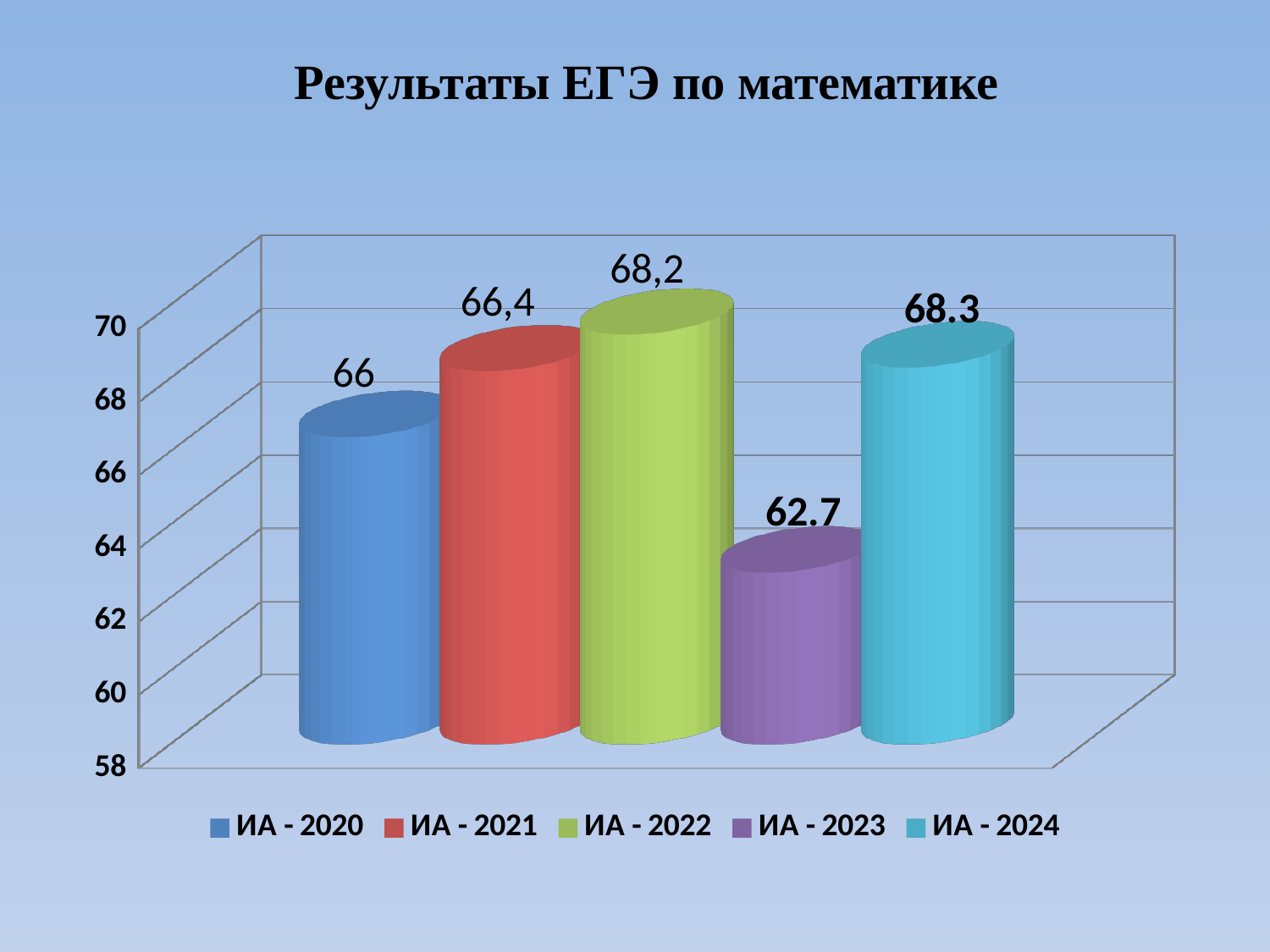
What is the value for ИА - 2023? 62.7 What kind of chart is shown on the slide? bar chart How many series does the legend list? 5 What is the difference between the values for ИА - 2024 and ИА - 2023? 5.6 Which series has the lowest value? ИА - 2023 What is the value for ИА - 2024? 68.3 What is the value for ИА - 2022? 68,2 What is the title of the chart? Результаты ЕГЭ по математике Which is larger, the value for ИА - 2021 or the value for ИА - 2020? ИА - 2021 What is the value for ИА - 2020? 66 Is the value for ИА - 2023 greater or less than 64? less